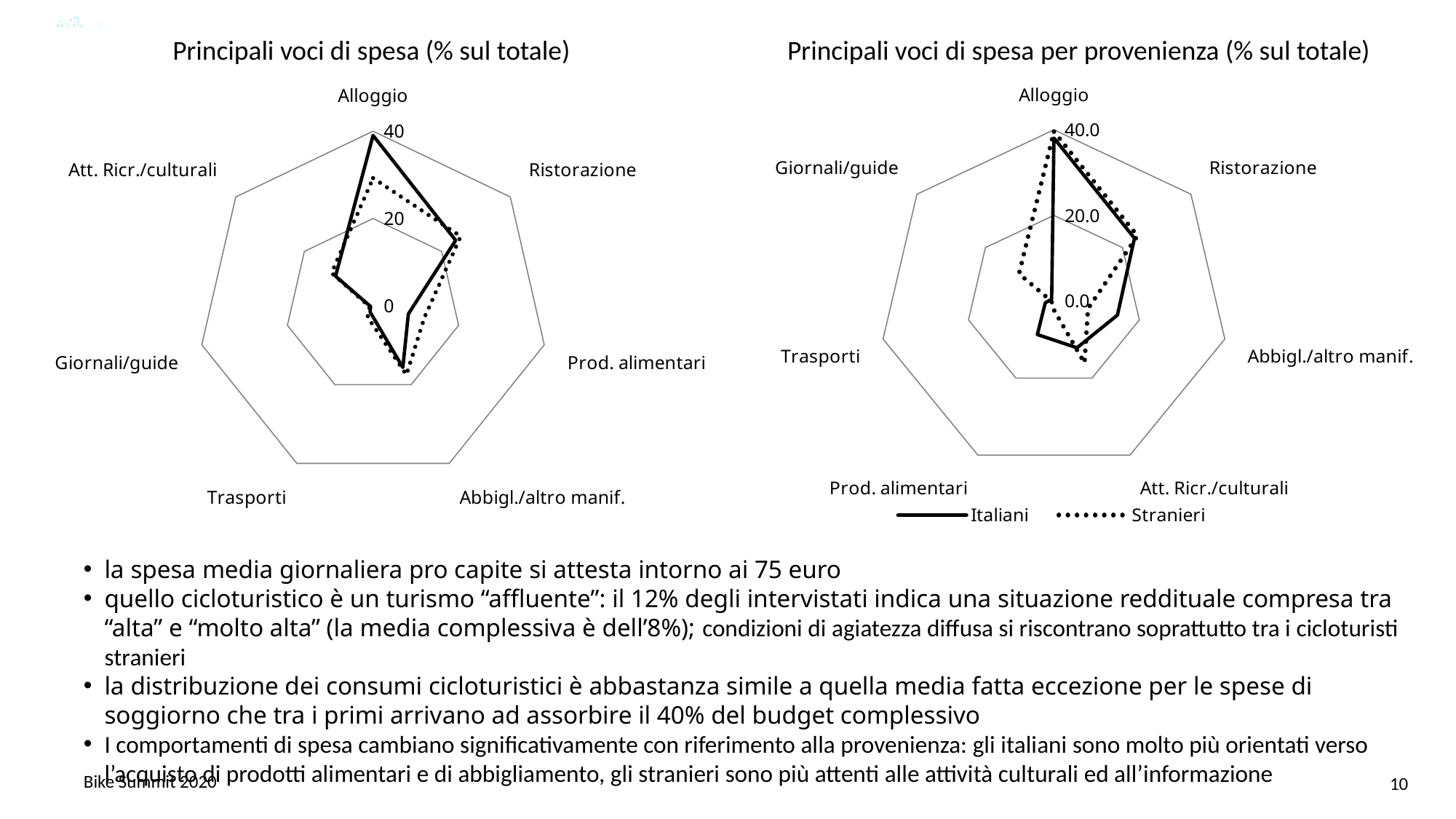
What are the two series named in the legend of the right-hand chart? Italiani and Stranieri In the right-hand chart, which category has the highest value for Italiani? Alloggio How many series does the legend of the right-hand chart list? 2 In the left-hand chart, is the solid-line value for Trasporti greater or less than 20? less How many categories are plotted on the right-hand chart 'Principali voci di spesa per provenienza (% sul totale)'? 7 What kind of chart is the chart titled 'Principali voci di spesa per provenienza (% sul totale)'? Radar chart In the right-hand chart, which is larger for Italiani: Alloggio or Att. Ricr./culturali? Alloggio In the right-hand chart, is the Italiani value for Trasporti greater or less than 20.0? less In the left-hand chart, is the solid-line value for Ristorazione greater or less than 20? greater How many spending categories are plotted on the left-hand chart 'Principali voci di spesa (% sul totale)'? 7